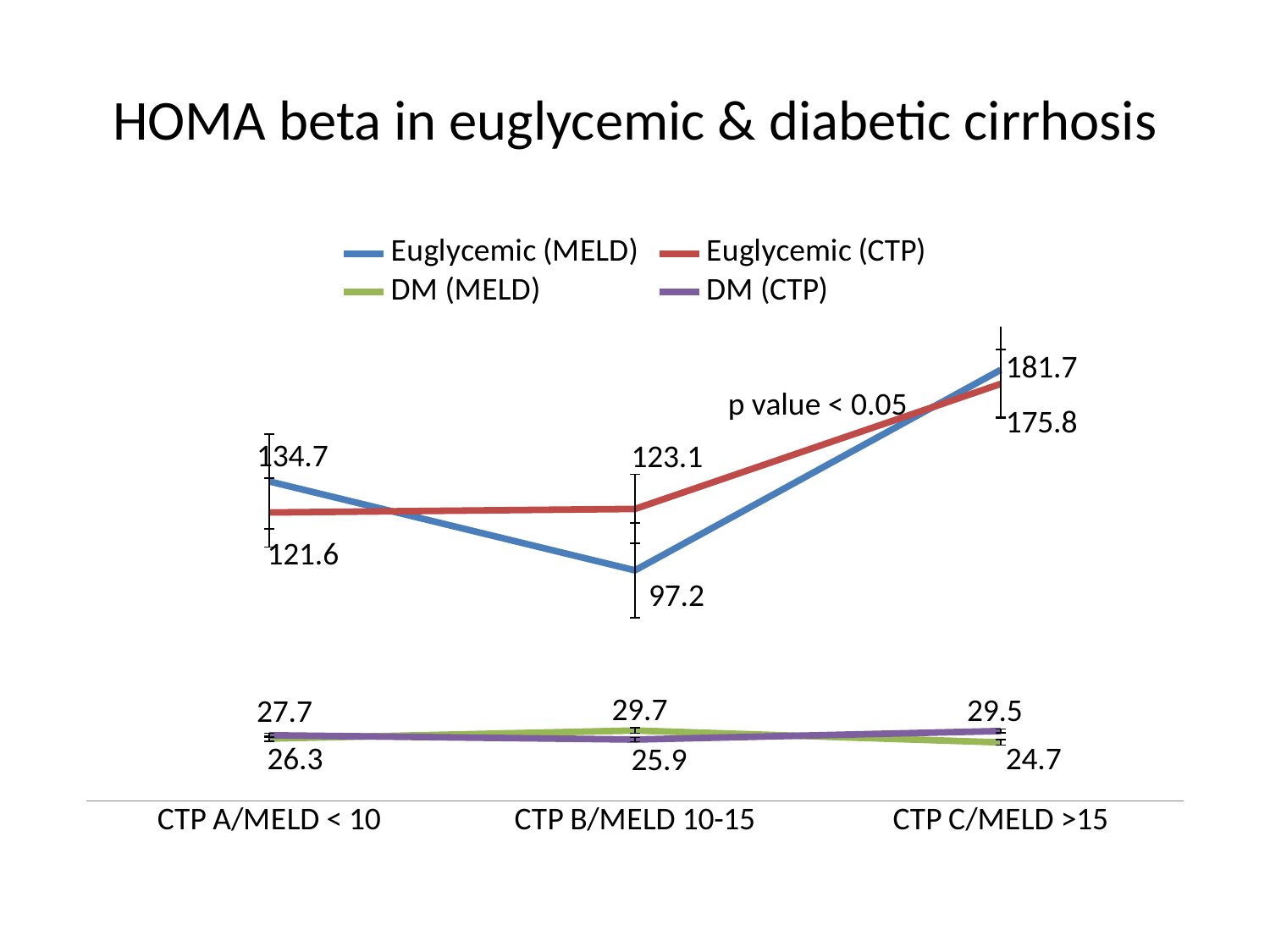
What is the value for DM (MELD) at CTP B/MELD 10-15? 29.7 What is the difference between Euglycemic (MELD) and Euglycemic (CTP) at CTP C/MELD >15? 5.9 What is the value for Euglycemic (CTP) at CTP C/MELD >15? 175.8 What is the value for DM (CTP) at CTP A/MELD < 10? 27.7 At which category is Euglycemic (MELD) lowest? CTP B/MELD 10-15 What type of chart is shown on the slide? line chart What is the value for Euglycemic (MELD) at CTP B/MELD 10-15? 97.2 Which is larger at CTP B/MELD 10-15: Euglycemic (CTP) or Euglycemic (MELD)? Euglycemic (CTP) How many series does the legend list? 4 At which category is Euglycemic (MELD) highest? CTP C/MELD >15 How many categories are shown on the x axis? 3 What is the title of the chart? HOMA beta in euglycemic & diabetic cirrhosis